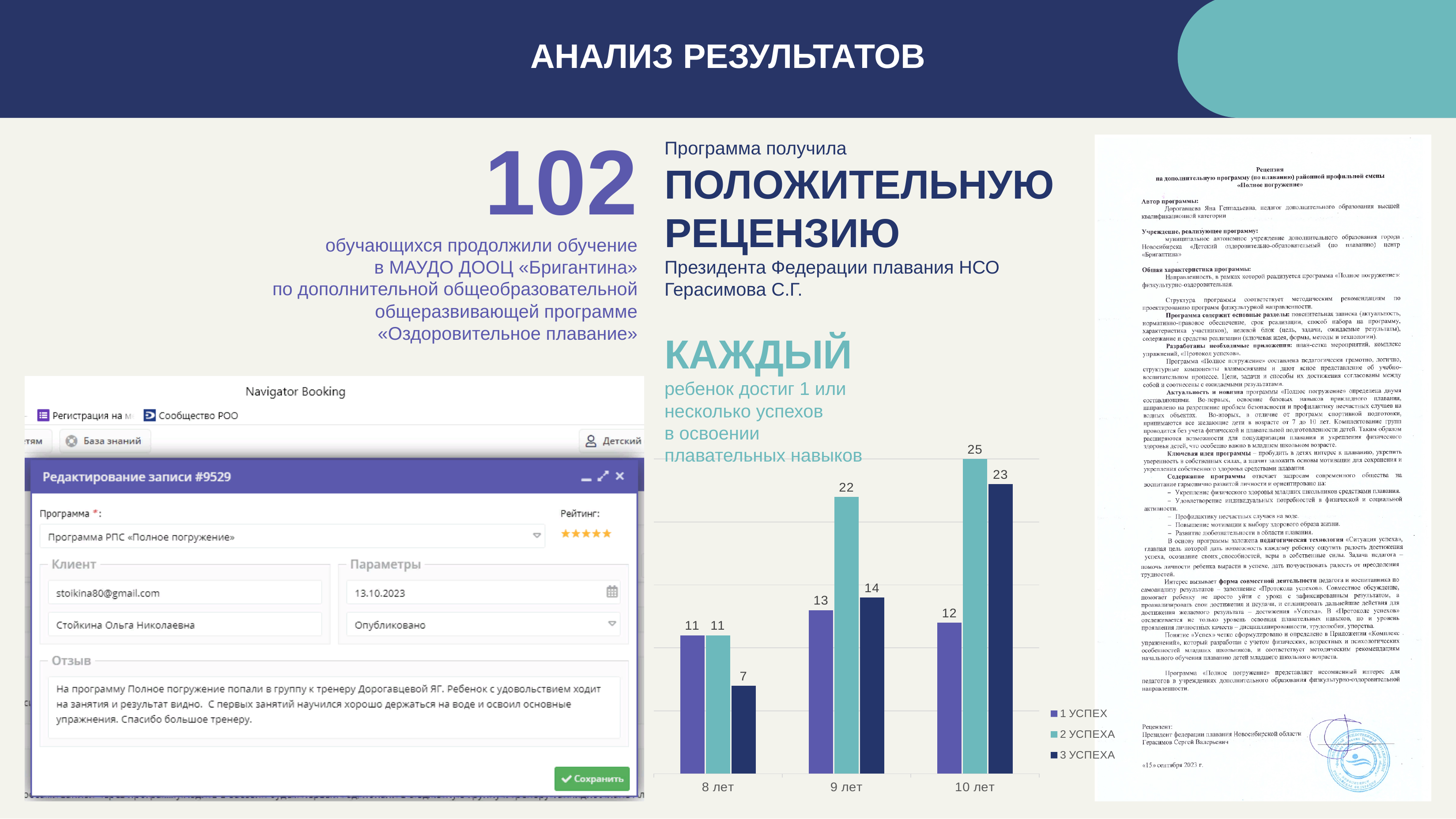
How many series does the chart legend list? 3 Which category has the lowest value for the "3 УСПЕХА" series? 8 лет What is the difference between the "2 УСПЕХА" and "3 УСПЕХА" values in the "9 лет" category? 8 What is the value for "3 УСПЕХА" in the "8 лет" category? 7 What type of chart is shown on the slide? bar chart Does the "2 УСПЕХА" series rise or fall from "8 лет" to "10 лет"? rise What is the value for "2 УСПЕХА" in the "9 лет" category? 22 What is the value for "1 УСПЕХ" in the "10 лет" category? 12 What is the total of the three series values in the "8 лет" category? 29 Which category has the highest value for the "2 УСПЕХА" series? 10 лет Which is larger in the "10 лет" category: "2 УСПЕХА" or "3 УСПЕХА"? 2 УСПЕХА How many age categories are shown on the x axis of the chart? 3